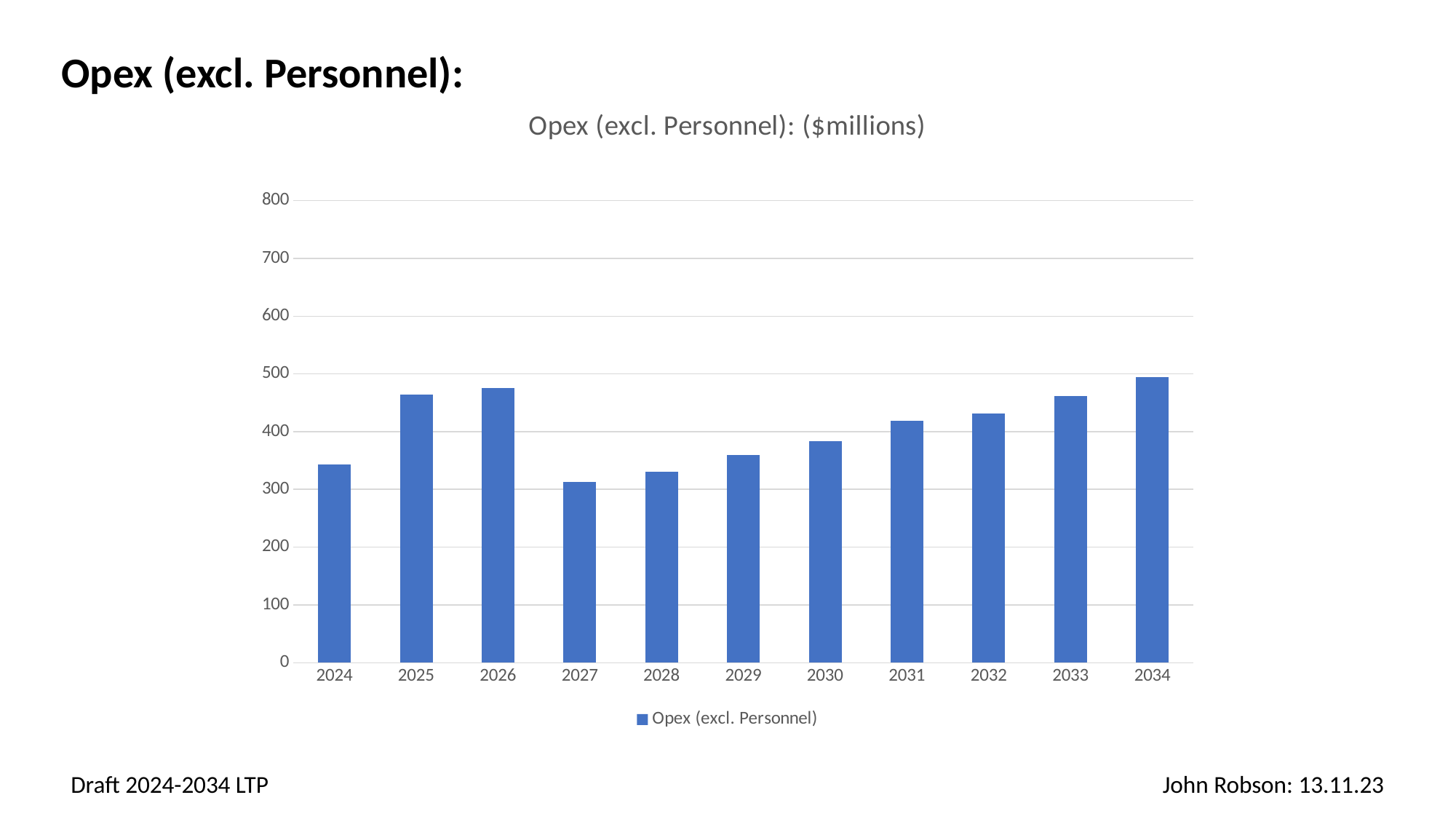
Is the value for 2029 greater or less than 400? less Do the values rise or fall from 2027 to 2034? rise Is the value for 2026 greater or less than 500? less Which year has the larger value, 2024 or 2025? 2025 How many years are shown on the x axis of the chart? 11 Which year has the highest Opex (excl. Personnel) value? 2034 What is the title of the chart? Opex (excl. Personnel): ($millions) How many series does the chart's legend list? 1 Is the value for 2024 greater or less than 400? less What kind of chart is shown on the slide? bar chart Which year has the lowest Opex (excl. Personnel) value? 2027